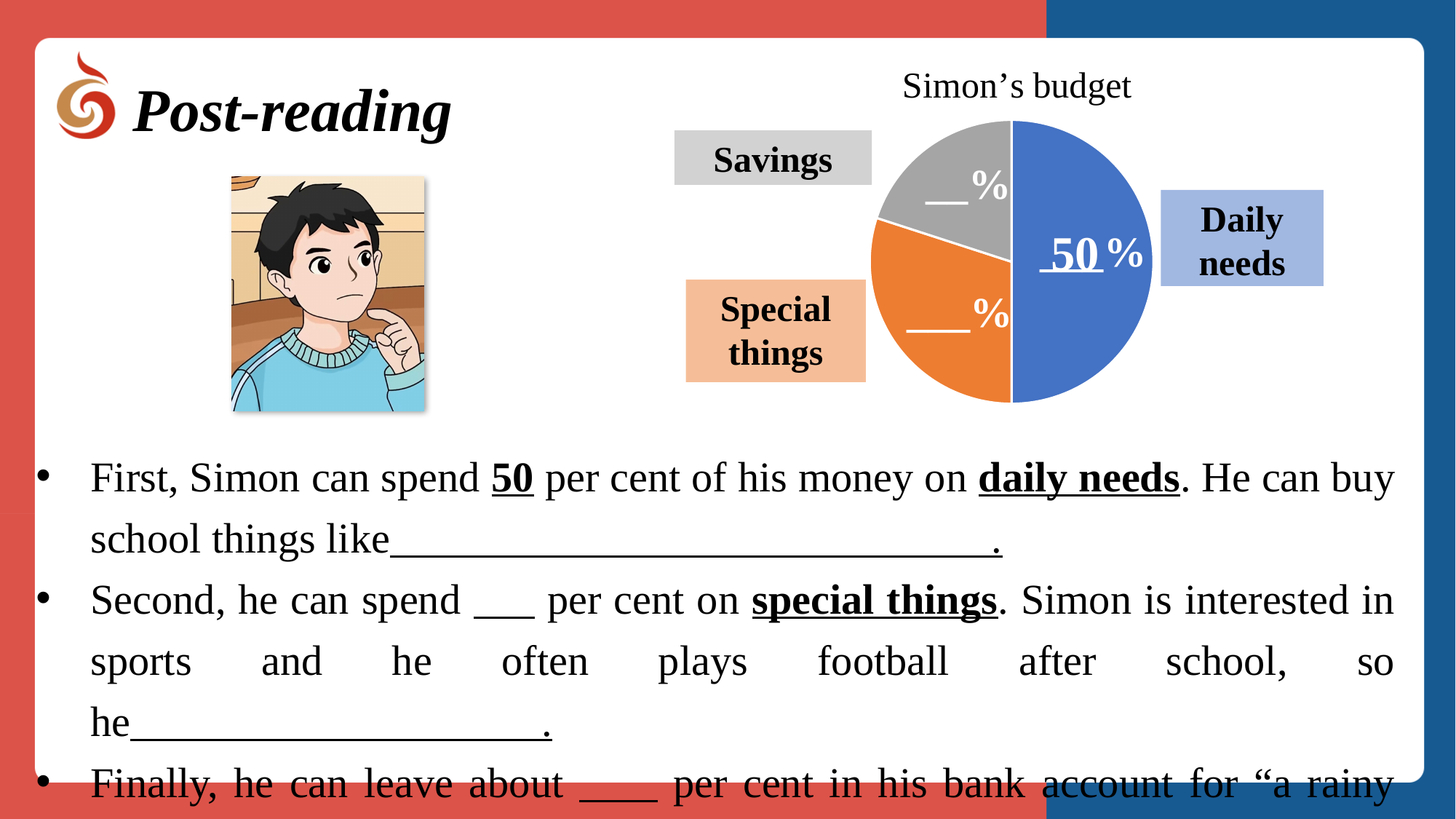
What is the title of the chart? Simon's budget Which category takes the largest share of Simon's budget? Daily needs What kind of chart is shown on the slide? pie chart What percentage of Simon's budget goes to Daily needs? 50% What share of the pie does the Daily needs slice represent? 50% What colour is the Daily needs slice in the pie chart? blue Which is larger, the slice for Special things or the slice for Savings? Special things How many categories does the pie chart have? 3 Which category takes the smallest share of Simon's budget? Savings